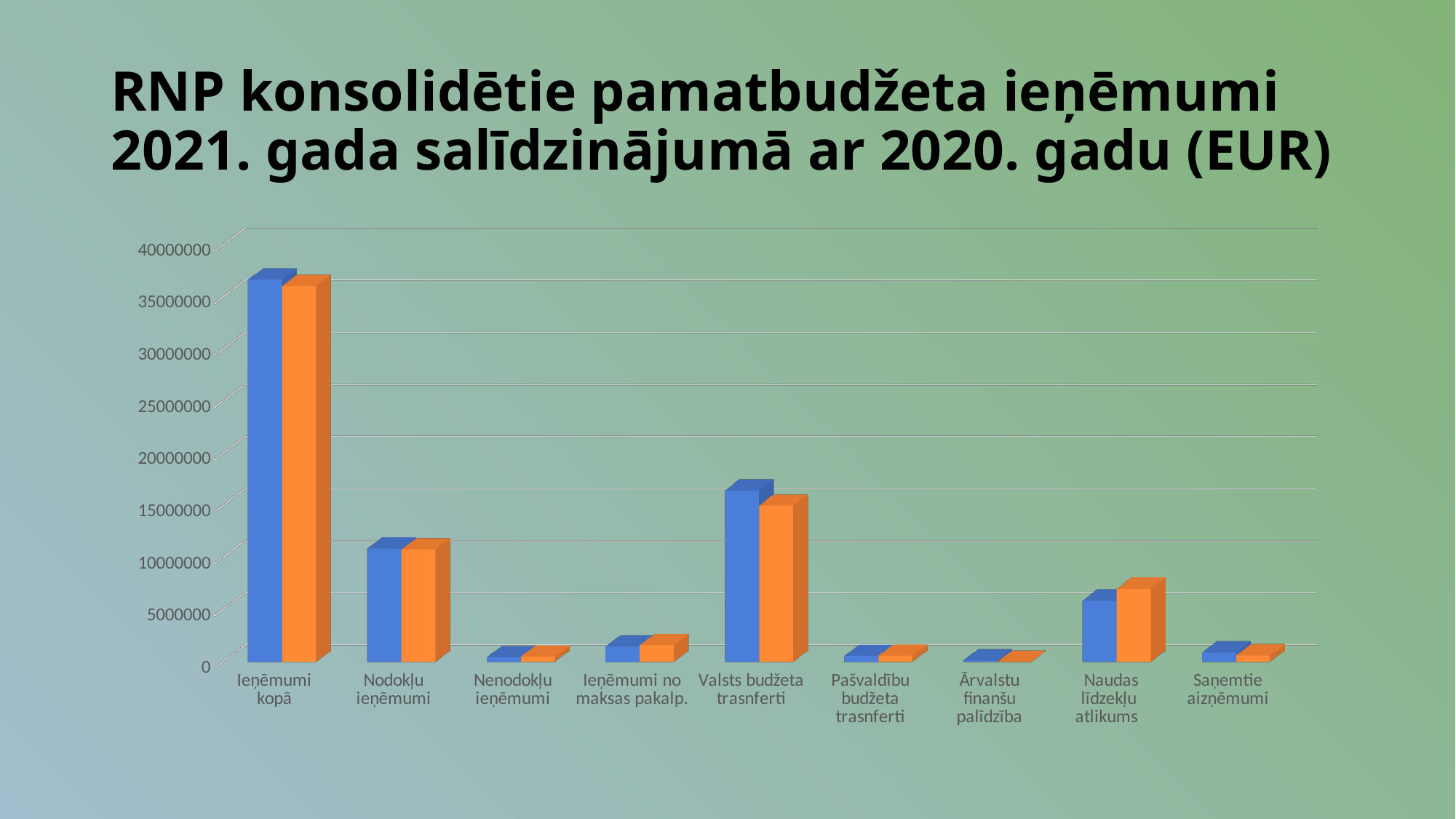
What is the title of the slide containing the chart? RNP konsolidētie pamatbudžeta ieņēmumi 2021. gada salīdzinājumā ar 2020. gadu (EUR) Which category has larger bars, Nodokļu ieņēmumi or Valsts budžeta trasnferti? Valsts budžeta trasnferti Which category has the lowest orange bar in the chart? Ārvalstu finanšu palīdzība Which category has the highest bars in the chart? Ieņēmumi kopā What two colours are used for the bars in the chart? blue and orange Is the blue bar for Valsts budžeta trasnferti greater or less than 15000000? greater Is the blue bar for Naudas līdzekļu atlikums greater or less than 10000000? less Is the blue bar for Nodokļu ieņēmumi greater or less than 15000000? less What kind of chart is shown on the slide? bar chart For Naudas līdzekļu atlikums, which bar is taller, the blue one or the orange one? the orange one How many categories are shown on the x axis of the chart? 9